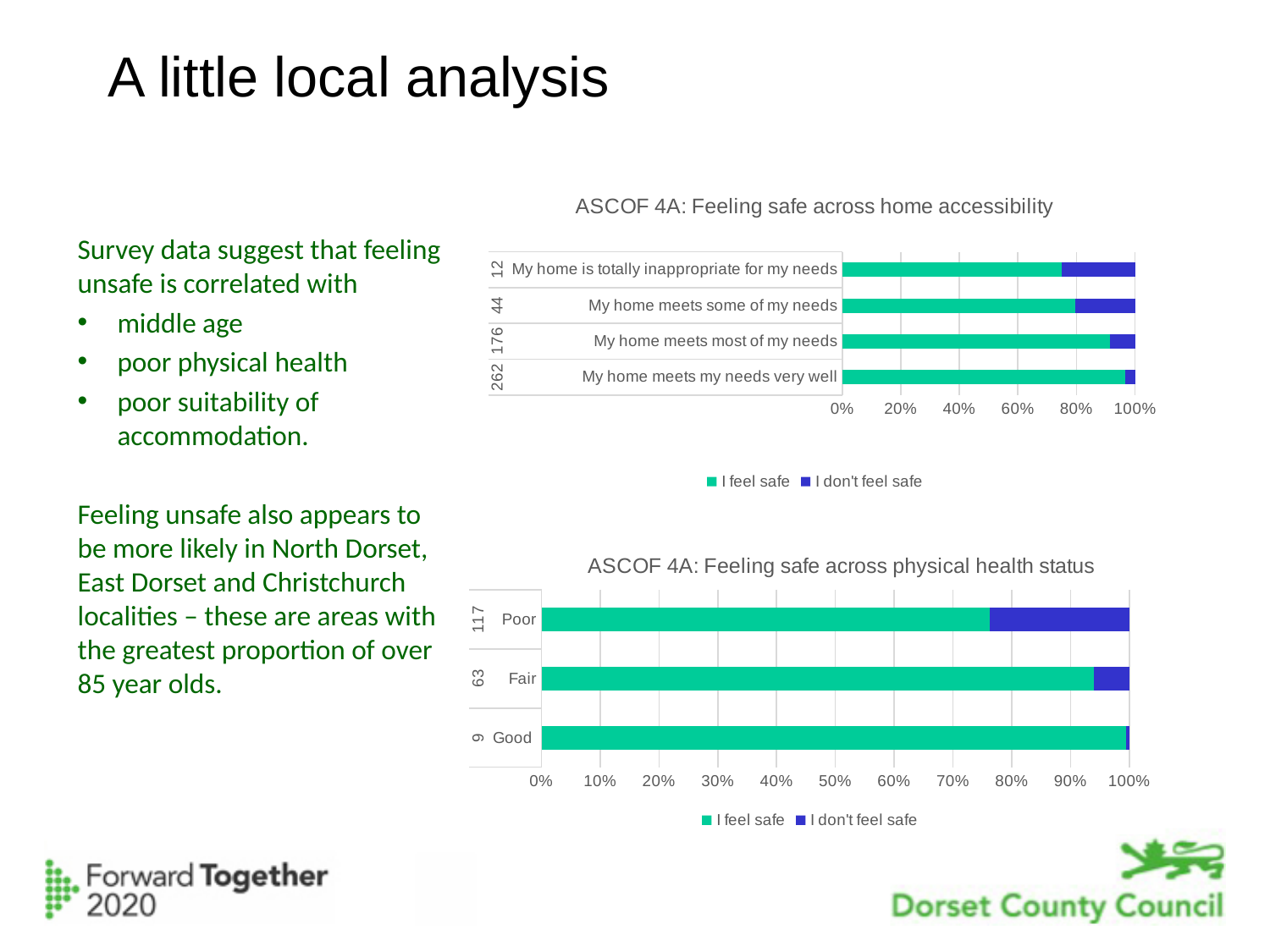
How many series does the legend of the 'Feeling safe across physical health status' chart list? 2 What kind of chart is 'ASCOF 4A: Feeling safe across home accessibility'? Stacked bar chart What are the two legend entries in the 'Feeling safe across physical health status' chart? I feel safe; I don't feel safe In the 'Feeling safe across physical health status' chart, which category has the smallest 'I feel safe' share? Poor In the 'Feeling safe across home accessibility' chart, which category has the largest 'I feel safe' share? My home meets my needs very well In the 'Feeling safe across home accessibility' chart, is the 'I feel safe' share for 'My home is totally inappropriate for my needs' greater or less than 80%? less How many categories are shown in the 'Feeling safe across home accessibility' chart? 4 How many categories are shown in the 'Feeling safe across physical health status' chart? 3 In the 'Feeling safe across home accessibility' chart, is the 'I feel safe' share for 'My home meets most of my needs' greater or less than 80%? greater In the 'Feeling safe across physical health status' chart, which has the larger 'I feel safe' share, 'Poor' or 'Good'? Good In the 'Feeling safe across physical health status' chart, is the 'I feel safe' share for 'Poor' greater or less than 70%? greater In the 'Feeling safe across home accessibility' chart, which category has the smallest 'I feel safe' share? My home is totally inappropriate for my needs